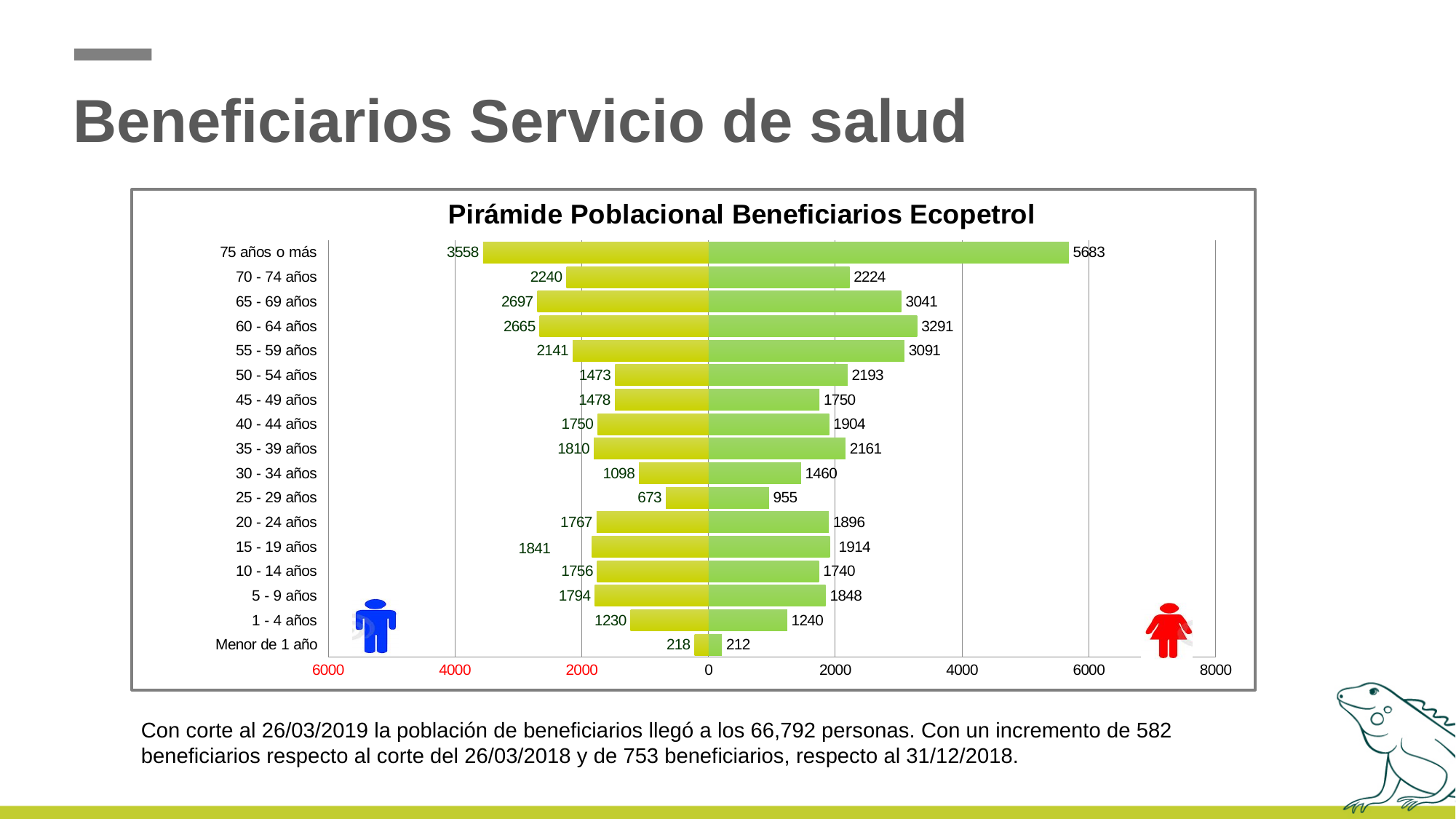
Is the value of the right-hand (green) bar for '65 - 69 años' greater or less than 2000? greater For the '55 - 59 años' age group, which is larger: the left-hand (yellow) bar or the right-hand (green) bar? the right-hand (green) bar How many age groups are shown on the chart? 17 Which age group has the highest value among the right-hand (green) bars? 75 años o más What is the value of the left-hand (yellow) bar for the '25 - 29 años' age group? 673 Which age group has the lowest value among the left-hand (yellow) bars? Menor de 1 año For the '75 años o más' age group, what is the difference between the right-hand (green) value and the left-hand (yellow) value? 2125 What is the title of the chart? Pirámide Poblacional Beneficiarios Ecopetrol What is the combined total of the left-hand and right-hand bars for the '60 - 64 años' age group? 5956 What is the value of the right-hand (green) bar for the '75 años o más' age group? 5683 What type of chart is shown on the slide? bar chart What is the value of the right-hand (green) bar for the '30 - 34 años' age group? 1460